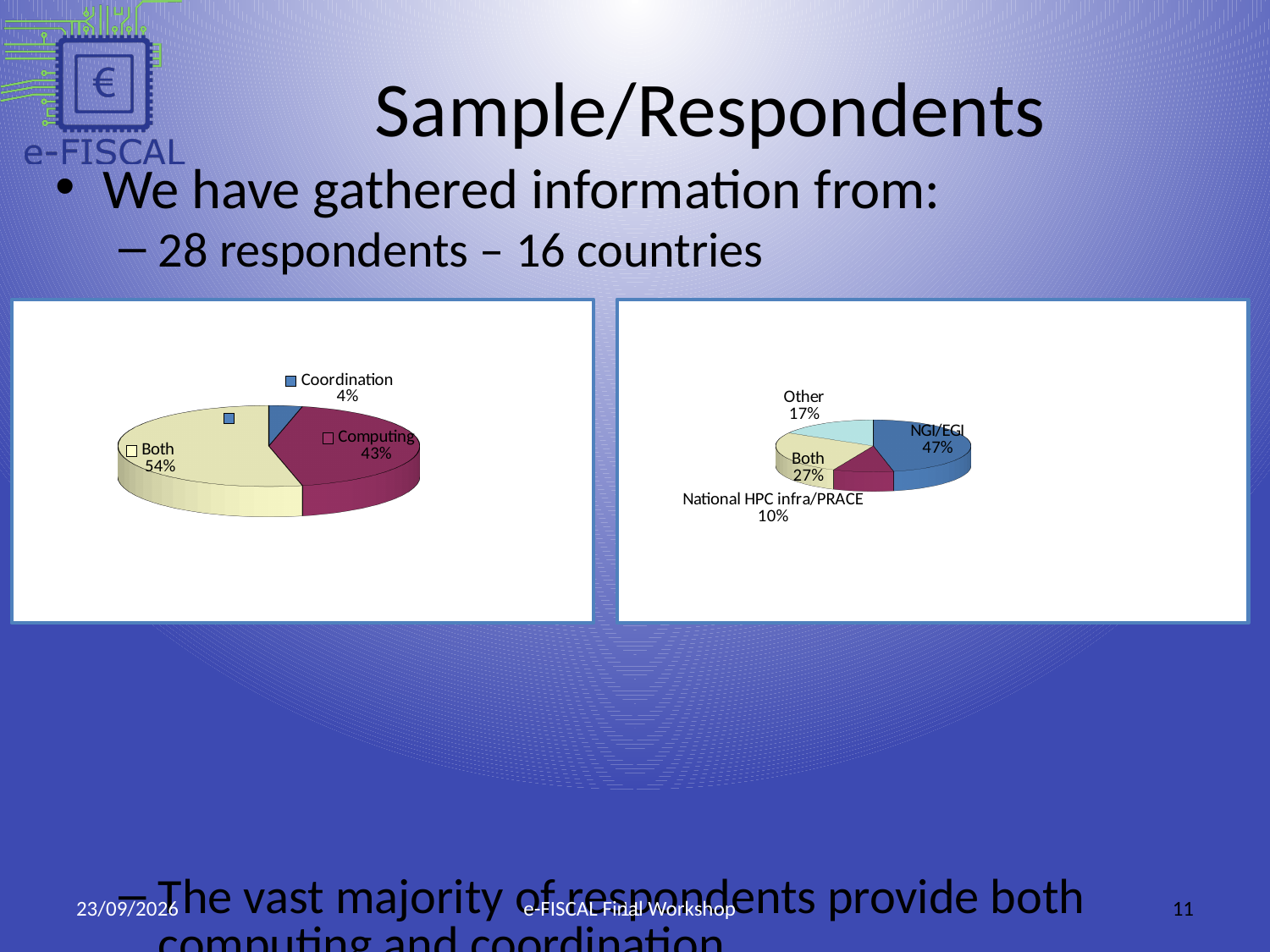
How many slices does the left pie chart have? 3 In the right pie chart, which is larger, Other or Both? Both In the left pie chart, what share is labelled for Both? 54% In the right pie chart, what share is labelled for National HPC infra/PRACE? 10% How many slices does the right pie chart have? 4 In the left pie chart, which category has the largest share? Both In the right pie chart, which category has the largest share? NGI/EGI In the left pie chart, what share is labelled for Computing? 43% In the left pie chart, what is the difference in percentage points between Both and Computing? 11 What type of chart is the right chart? pie chart In the left pie chart, which category has the smallest share? Coordination In the right pie chart, what share is labelled for NGI/EGI? 47%